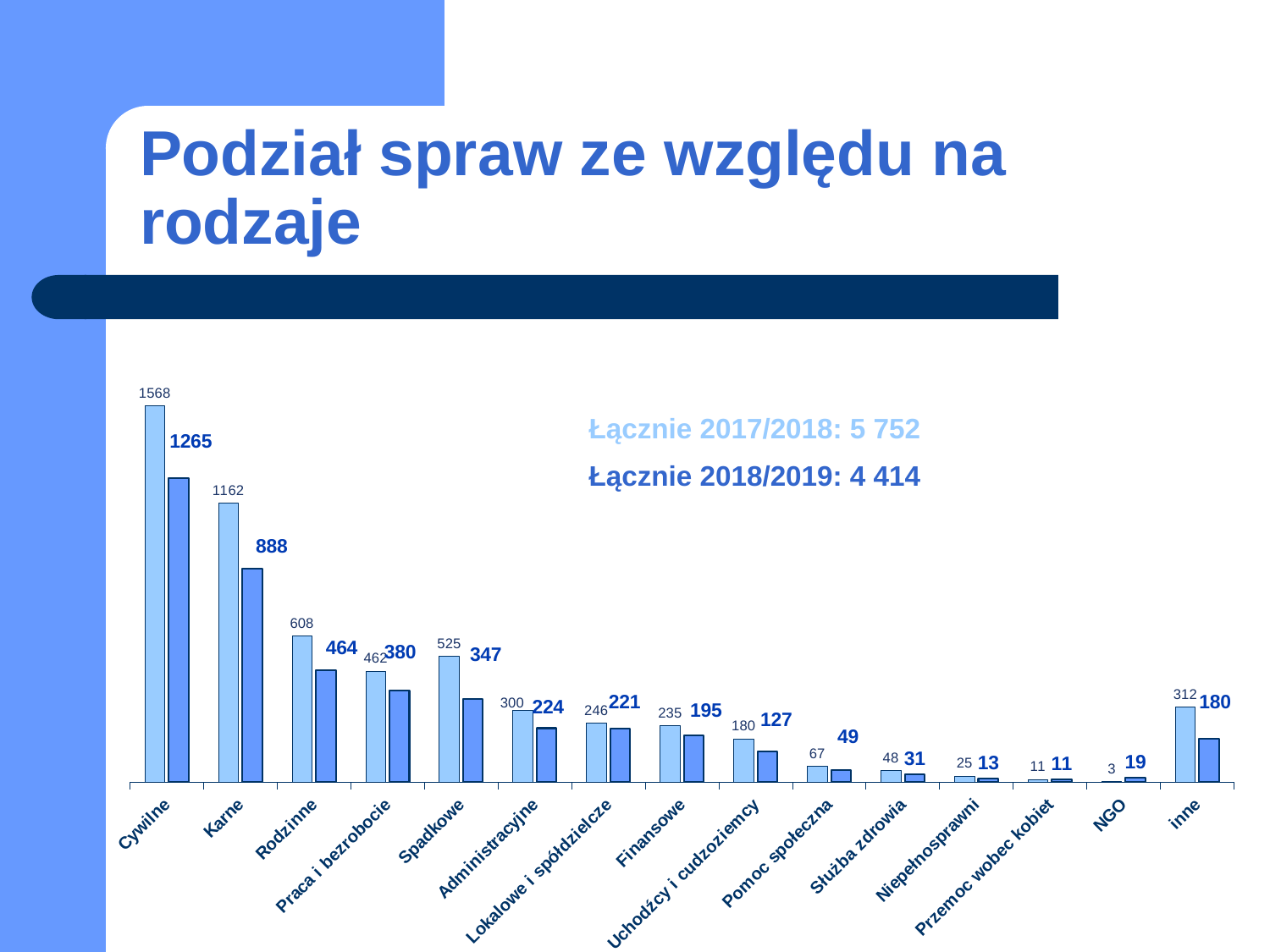
How many categories are shown on the x axis of the chart? 15 Which is larger for NGO, the light blue bar or the dark blue bar? the dark blue bar What is the value of the light blue bar for Cywilne? 1568 What is the value of the dark blue bar for Spadkowe? 347 Which category has the highest light blue bar? Cywilne What is the title of the slide containing the chart? Podział spraw ze względu na rodzaje What total is given on the slide for 2018/2019? 4 414 What kind of chart is shown on the slide? bar chart What is the value of the dark blue bar for Karne? 888 Which category has the lowest light blue bar? NGO What is the difference between the light blue and dark blue bars for Rodzinne? 144 What is the value of the light blue bar for inne? 312